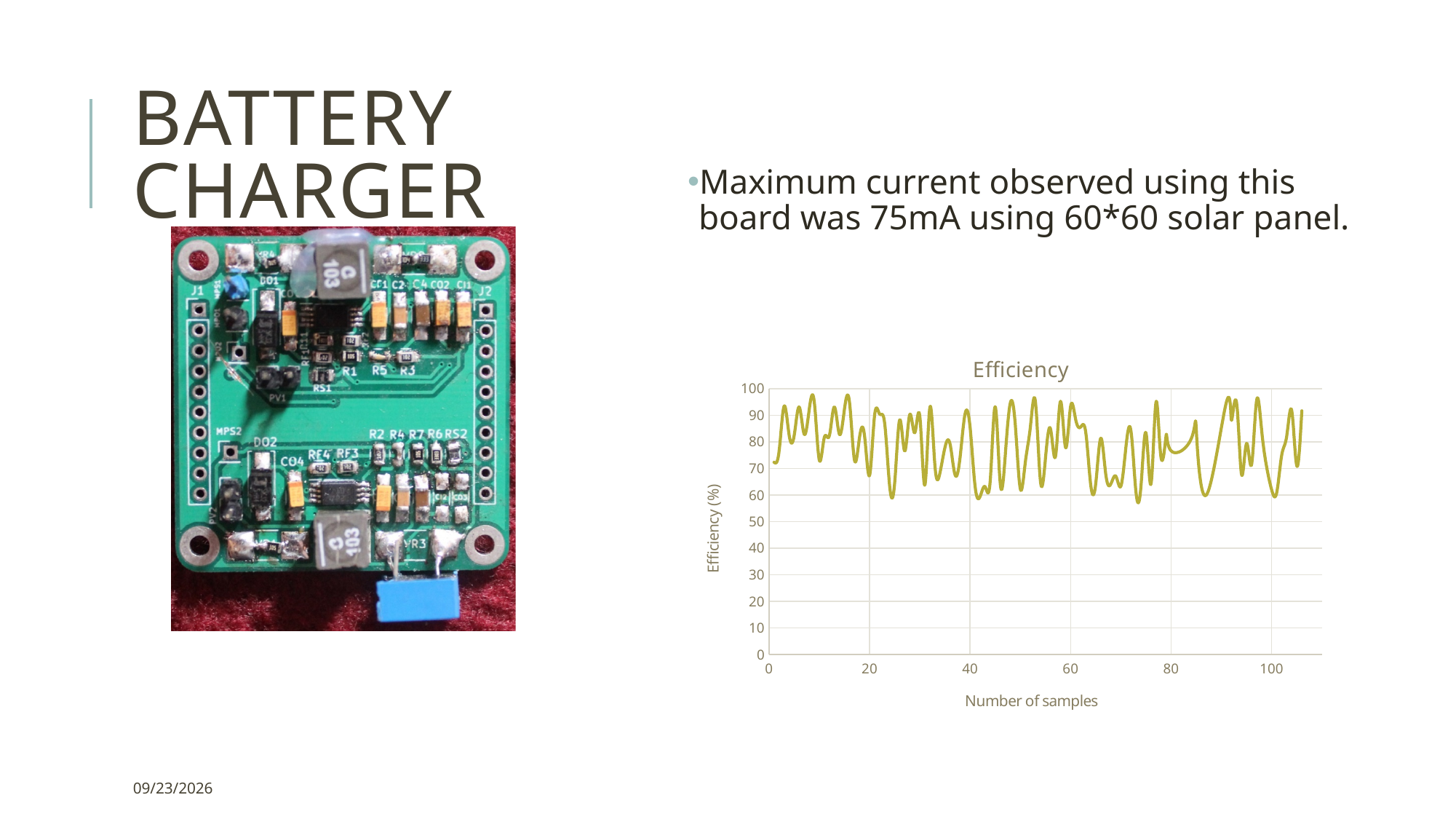
Is the efficiency value at the first sample (x = 0) greater or less than 50? greater What kind of chart is shown on the slide? Line chart Is the lowest efficiency value on the chart greater or less than 50? greater Is the efficiency value at the first sample (x = 0) greater or less than 80? less Do the efficiency values show a steady rise, a steady fall, or fluctuation along the x axis? fluctuation What is the label of the x axis of the chart? Number of samples What is the title of the chart? Efficiency How many lines (series) are plotted on the chart? 1